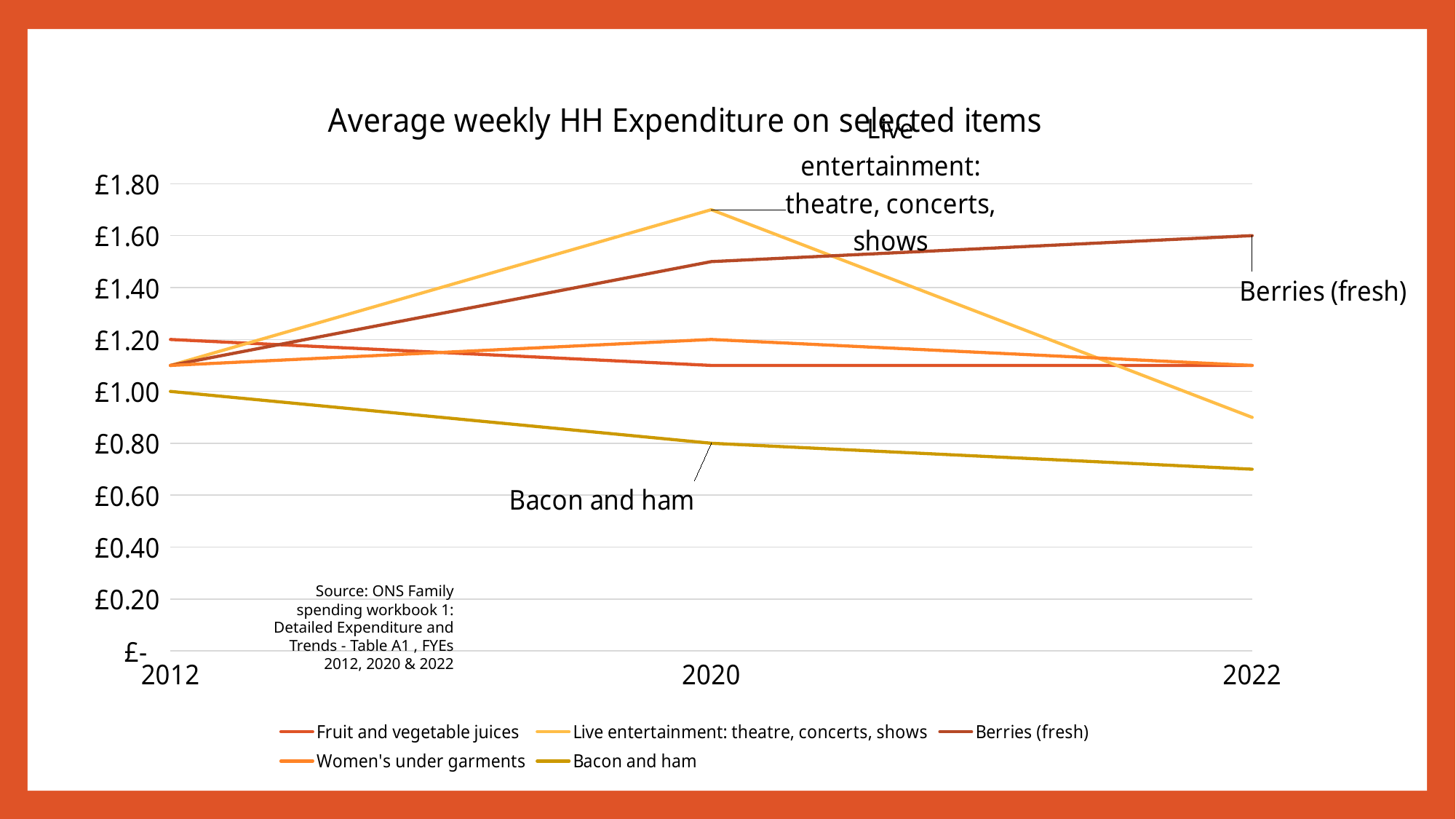
How many series does the legend list? 5 What kind of chart is shown on the slide? line chart Which series has the highest value in 2020? Live entertainment: theatre, concerts, shows Is the value for Live entertainment: theatre, concerts, shows in 2022 greater or less than £1.00? less What is the value for Bacon and ham in 2020? £0.80 How many years are shown on the x axis? 3 Which series has the lowest value in 2022? Bacon and ham What is the value for Berries (fresh) in 2022? £1.60 By how much did the value for Bacon and ham fall between 2012 and 2020? £0.20 What is the value for Bacon and ham in 2012? £1.00 Does the value for Berries (fresh) rise or fall from 2012 to 2022? rise What is the value for Fruit and vegetable juices in 2012? £1.20